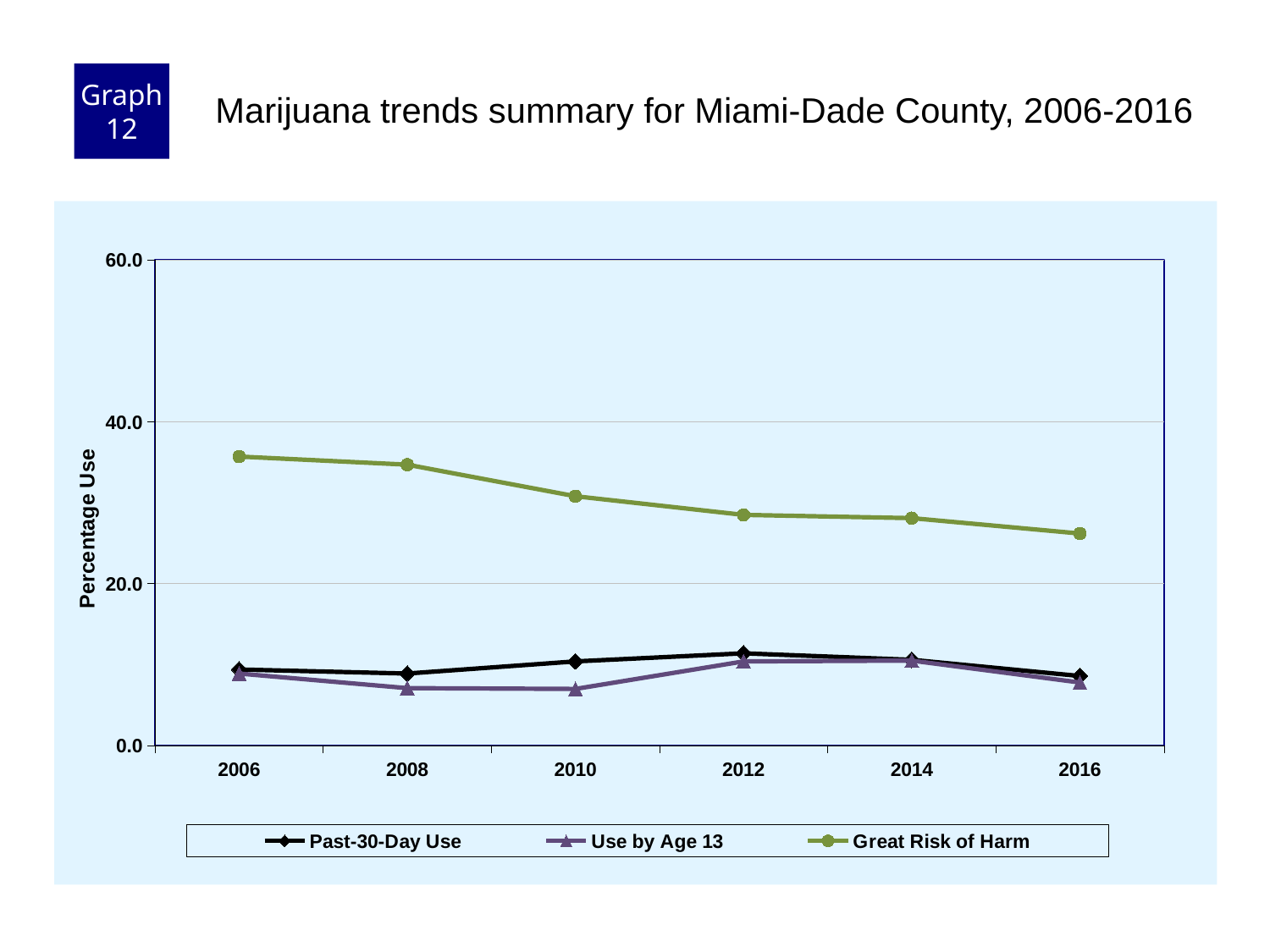
What is the title of the slide's chart? Marijuana trends summary for Miami-Dade County, 2006-2016 What kind of chart is shown on the slide? Line chart How many series does the legend list? 3 Which series has the highest values across all years? Great Risk of Harm Is the Past-30-Day Use value for 2012 greater or less than 20.0? less In 2016, which is larger: Great Risk of Harm or Past-30-Day Use? Great Risk of Harm Does the Great Risk of Harm series rise or fall from 2006 to 2016? Fall Is the Great Risk of Harm value for 2006 greater or less than 40.0? less Is the Great Risk of Harm value for 2016 greater or less than 20.0? greater What is the label on the y axis? Percentage Use In which year is the Great Risk of Harm value lowest? 2016 How many years are plotted along the x axis? 6